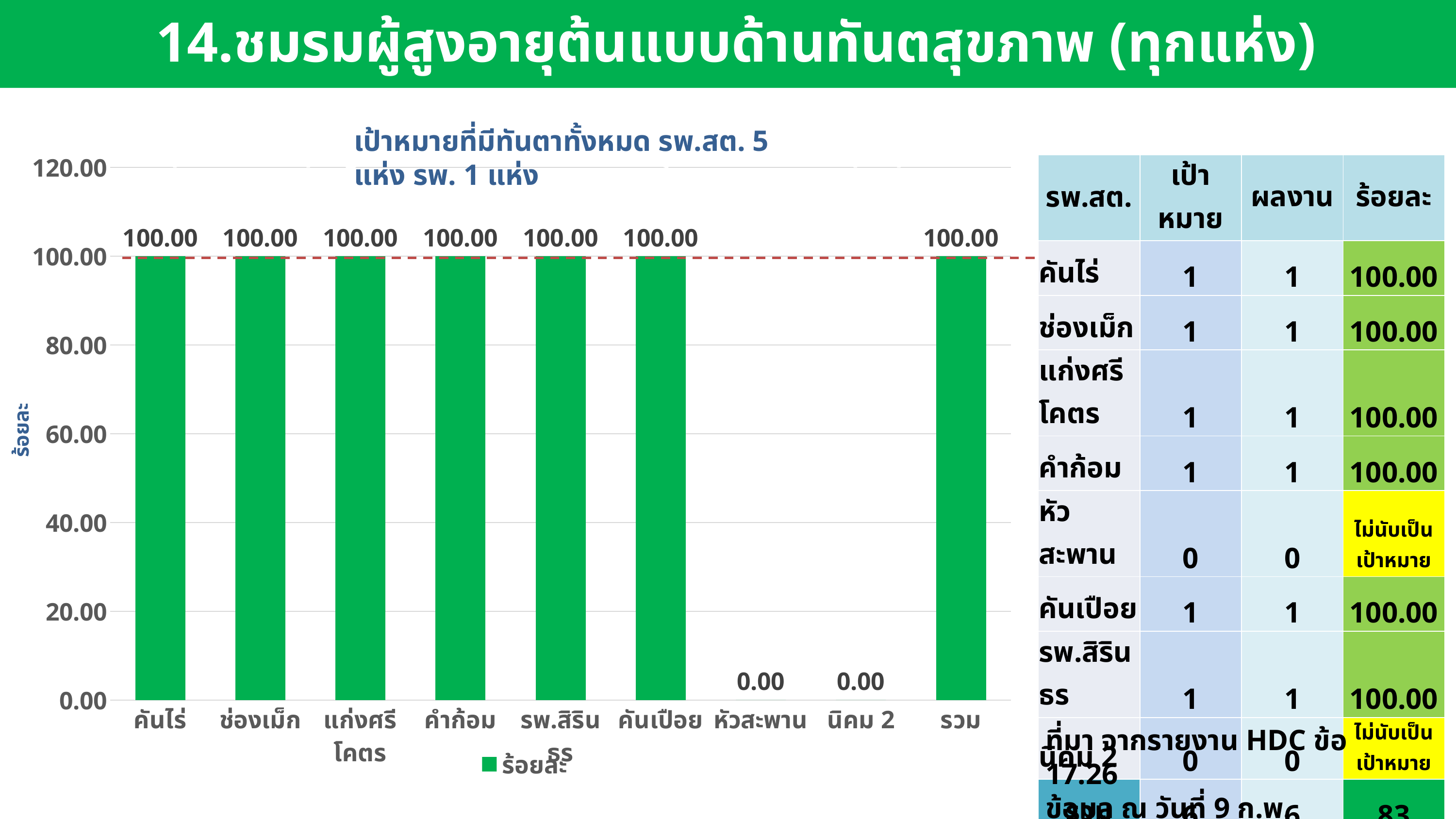
How many categories are shown on the x axis? 9 What is the value for คันเปือย? 100.00 What is the value for รวม? 100.00 Is the value for แก่งศรีโคตร greater or less than 80.00? greater What is the value for คันไร่? 100.00 Which is larger, the value for ช่องเม็ก or the value for หัวสะพาน? ช่องเม็ก How many series does the legend list? 1 What is the value for นิคม 2? 0.00 What kind of chart is shown? bar chart What is the difference between the values for คำก้อม and นิคม 2? 100.00 What is the value for หัวสะพาน? 0.00 What is the legend entry for the series? ร้อยละ